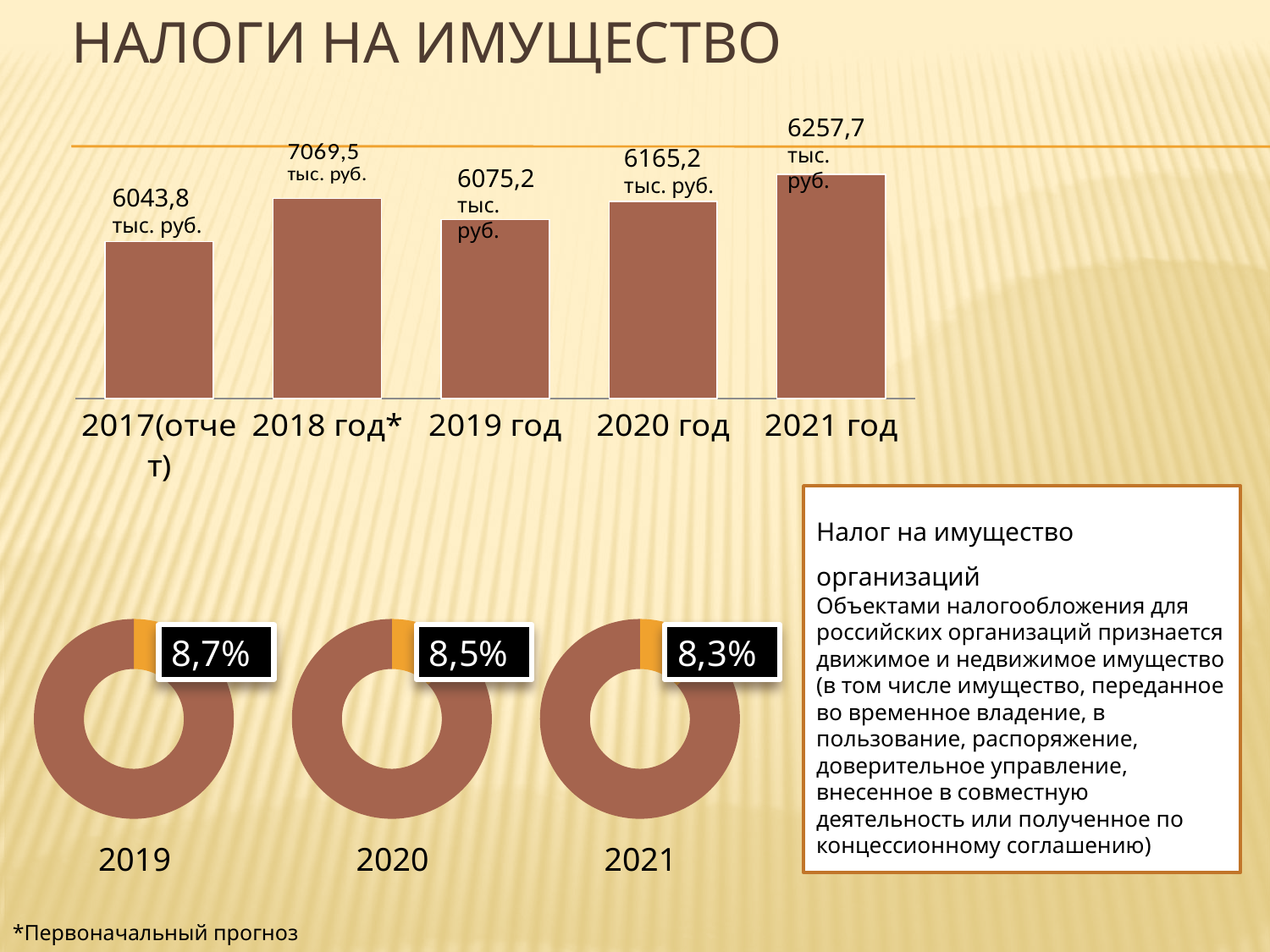
In the bar chart at the top of the slide, what is the value for 2021 год? 6257,7 тыс. руб. In the bar chart at the top of the slide, which year has the lowest value? 2017(отчет) In the donut chart labelled 2021 at the bottom of the slide, what percentage is shown? 8,3% In the donut chart labelled 2019 at the bottom of the slide, what percentage is shown? 8,7% In the bar chart at the top of the slide, what is the difference between the values for 2018 год* and 2017(отчет)? 1025,7 тыс. руб. What kind of chart is shown at the top of the slide? Bar chart In the bar chart at the top of the slide, do the values rise or fall from 2019 год to 2021 год? Rise How many bars are in the bar chart at the top of the slide? 5 In the bar chart at the top of the slide, what is the value for 2017(отчет)? 6043,8 тыс. руб. In the bar chart at the top of the slide, which is larger, the value for 2020 год or the value for 2019 год? 2020 год In the bar chart at the top of the slide, what is the value for 2018 год*? 7069,5 тыс. руб.